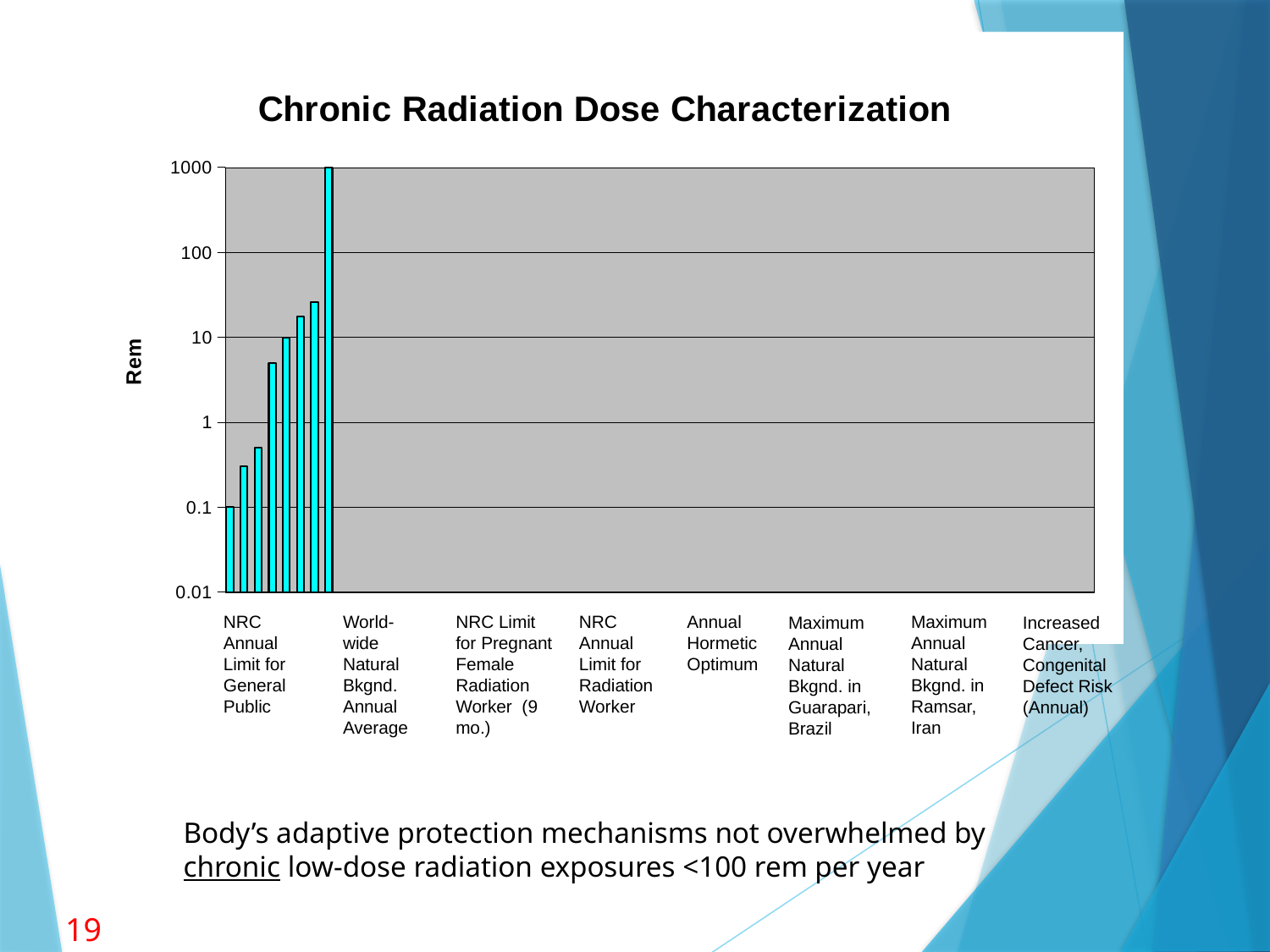
Is the value for Maximum Annual Natural Bkgnd. in Ramsar, Iran greater or less than 10? greater Is the value for World-wide Natural Bkgnd. Annual Average greater or less than 1? less Which category has the highest value in the chart? Increased Cancer, Congenital Defect Risk (Annual) How many bars are plotted in the chart? 8 Which category has the lowest value in the chart? NRC Annual Limit for General Public What is the value in Rem for Annual Hormetic Optimum? 10 What is the label on the vertical axis of the chart? Rem What kind of chart is shown on the slide? bar chart What is the value in Rem for NRC Annual Limit for General Public? 0.1 What is the value in Rem for Increased Cancer, Congenital Defect Risk (Annual)? 1000 Is the value for NRC Annual Limit for Radiation Worker greater or less than 1? greater Do the bar values rise or fall from left to right across the categories? rise